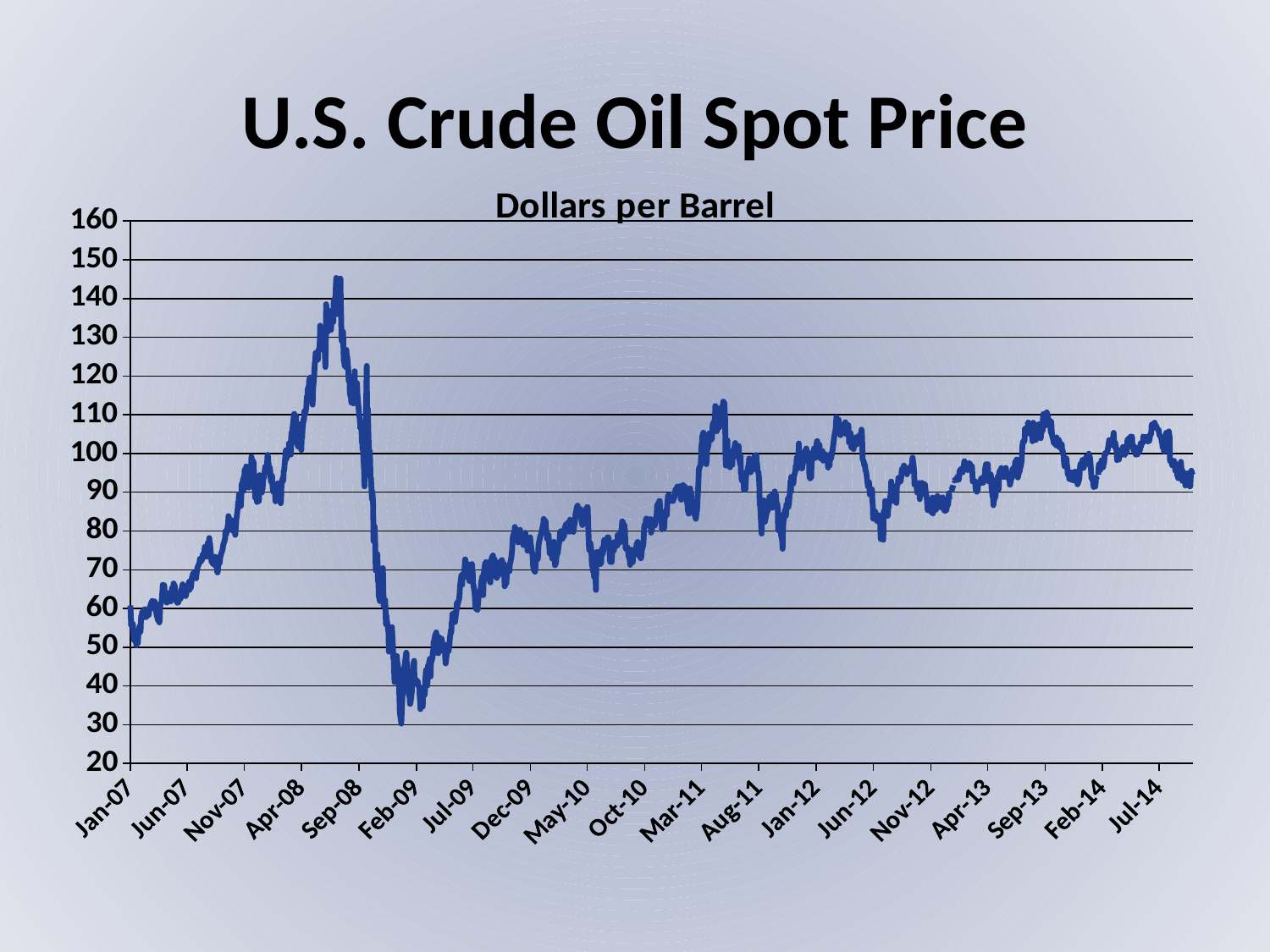
Is the crude oil spot price at Jan-12 greater or less than 90? greater Is the crude oil spot price at Feb-09 greater or less than 50? less Does the crude oil spot price rise or fall between Sep-08 and Feb-09? fall Is the lowest point of the crude oil spot price greater or less than 40? less How many date labels are shown on the x axis? 19 What is the title of the chart? Dollars per Barrel Does the crude oil spot price rise or fall between Jan-07 and Sep-08? rise What kind of chart is shown on the slide? line chart What unit is the crude oil price plotted in, according to the chart subtitle? Dollars per Barrel Which is higher, the crude oil spot price at Sep-08 or at Feb-09? Sep-08